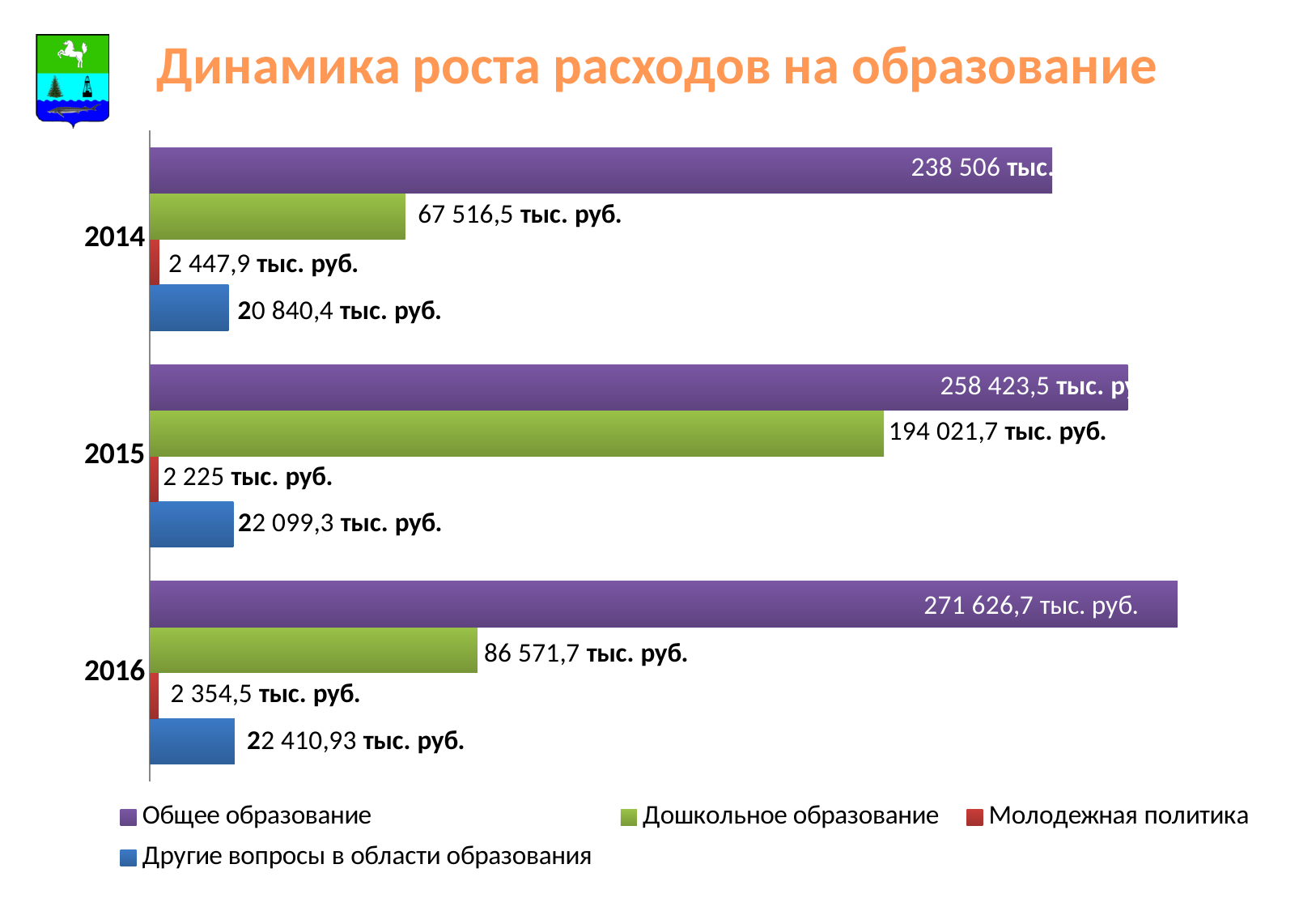
Which is larger: Дошкольное образование in 2015 or Дошкольное образование in 2016? 2015 What is the value for Дошкольное образование in 2015? 194 021,7 тыс. руб. What is the value for Молодежная политика in 2014? 2 447,9 тыс. руб. How many series does the legend list? 4 What kind of chart is shown on the slide? Bar chart Does the value for Общее образование rise or fall from 2014 to 2016? Rise Which series has the lowest value in 2015? Молодежная политика What is the difference between the Общее образование values for 2016 and 2015? 13 203,2 тыс. руб. How many years are shown on the chart? 3 What is the value for Другие вопросы в области образования in 2016? 22 410,93 тыс. руб. In which year is the value for Общее образование the highest? 2016 What is the value for Общее образование in 2016? 271 626,7 тыс. руб.